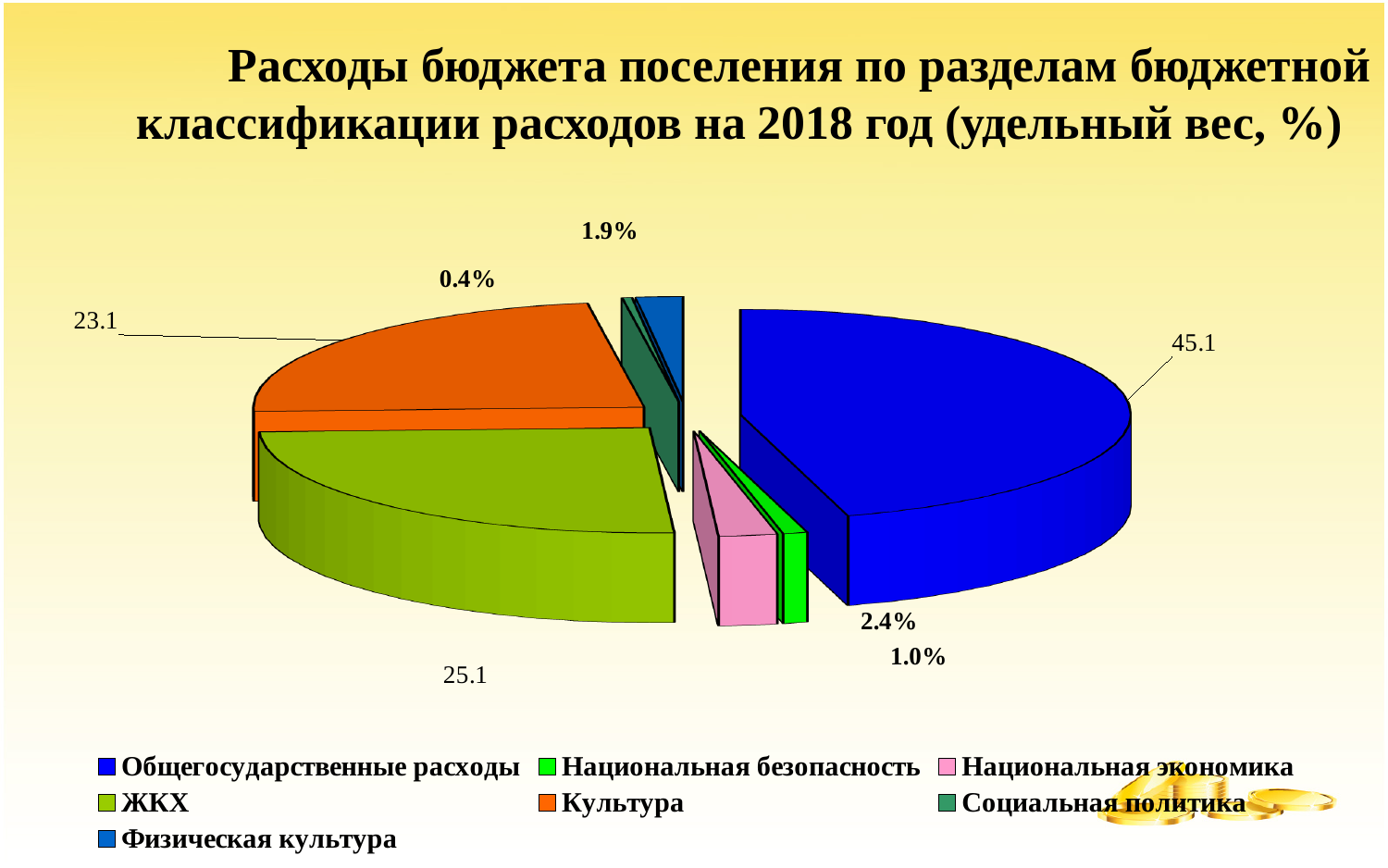
What is the value shown for Культура? 23.1 What is the value shown for Национальная экономика? 2.4% What is the value shown for Национальная безопасность? 1.0% Which category has the largest share of the pie? Общегосударственные расходы What kind of chart is shown on the slide? pie chart Which is larger, ЖКХ or Культура? ЖКХ What is the value shown for ЖКХ? 25.1 How many categories does the legend list? 7 What is the difference between the values for Общегосударственные расходы and ЖКХ? 20.0 Which colour represents Культура in the chart? orange What is the value shown for Общегосударственные расходы? 45.1 What is the difference between the values for ЖКХ and Культура? 2.0